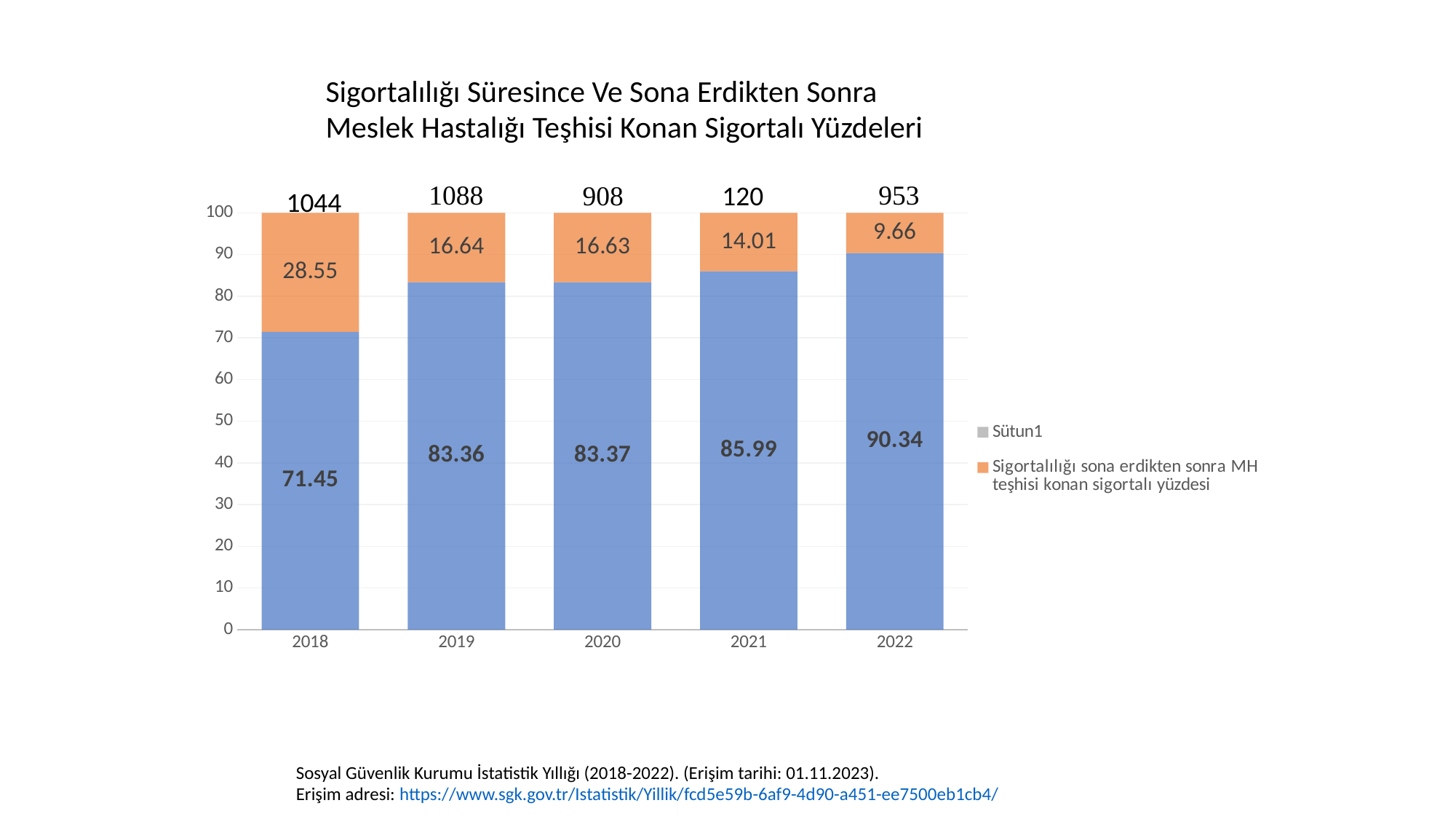
What is the value of the blue segment for 2022? 90.34 What number is printed above the bar for 2019? 1088 Which year has the highest value for the orange segment (Sigortalılığı sona erdikten sonra MH teşhisi konan sigortalı yüzdesi)? 2018 What is the difference between the orange segment values for 2018 and 2022? 18.89 Which year has the lowest value for the blue segment? 2018 What is the value of the orange segment (Sigortalılığı sona erdikten sonra MH teşhisi konan sigortalı yüzdesi) for 2018? 28.55 How many entries does the chart legend list? 2 What is the value of the orange segment for 2021? 14.01 Is the blue segment value for 2021 larger or smaller than the blue segment value for 2019? larger What type of chart is shown on the slide? stacked bar chart How many years are shown on the x axis of the chart? 5 Does the orange segment (Sigortalılığı sona erdikten sonra MH teşhisi konan sigortalı yüzdesi) rise or fall from 2018 to 2022? fall